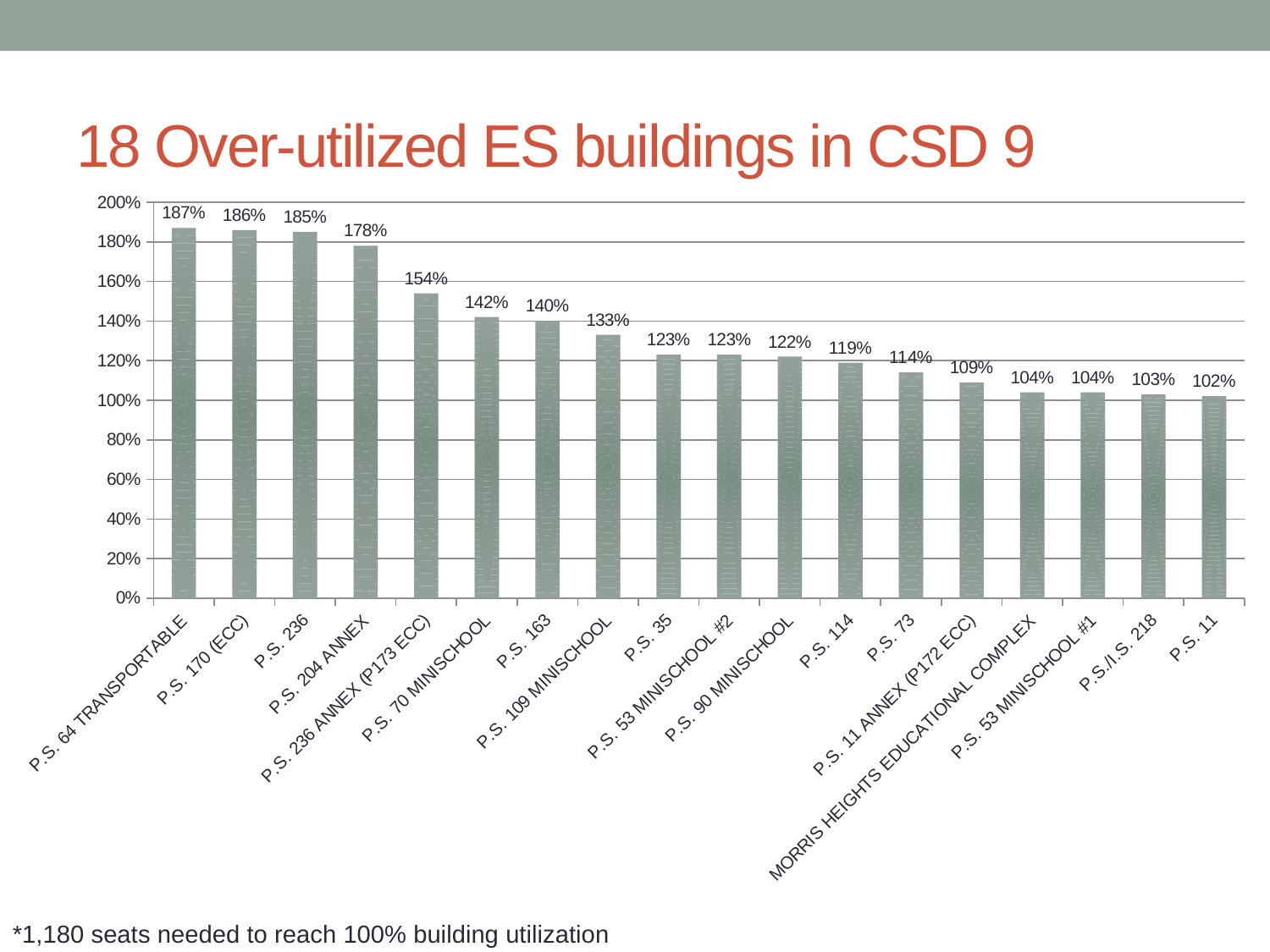
Is the value for P.S. 114 greater or less than 100%? greater What type of chart is shown on the slide? bar chart What is the utilization value for P.S. 236 ANNEX (P173 ECC)? 154% Which has a higher utilization, P.S. 70 MINISCHOOL or P.S. 109 MINISCHOOL? P.S. 70 MINISCHOOL Which building has the highest utilization? P.S. 64 TRANSPORTABLE How many buildings are shown in the chart? 18 What is the utilization value for P.S./I.S. 218? 103% What is the utilization value for P.S. 73? 114% Which building has the lowest utilization? P.S. 11 What is the difference between the utilization of P.S. 204 ANNEX and P.S. 163? 38% Do the values rise or fall from left to right along the x axis? fall What is the utilization value for P.S. 64 TRANSPORTABLE? 187%